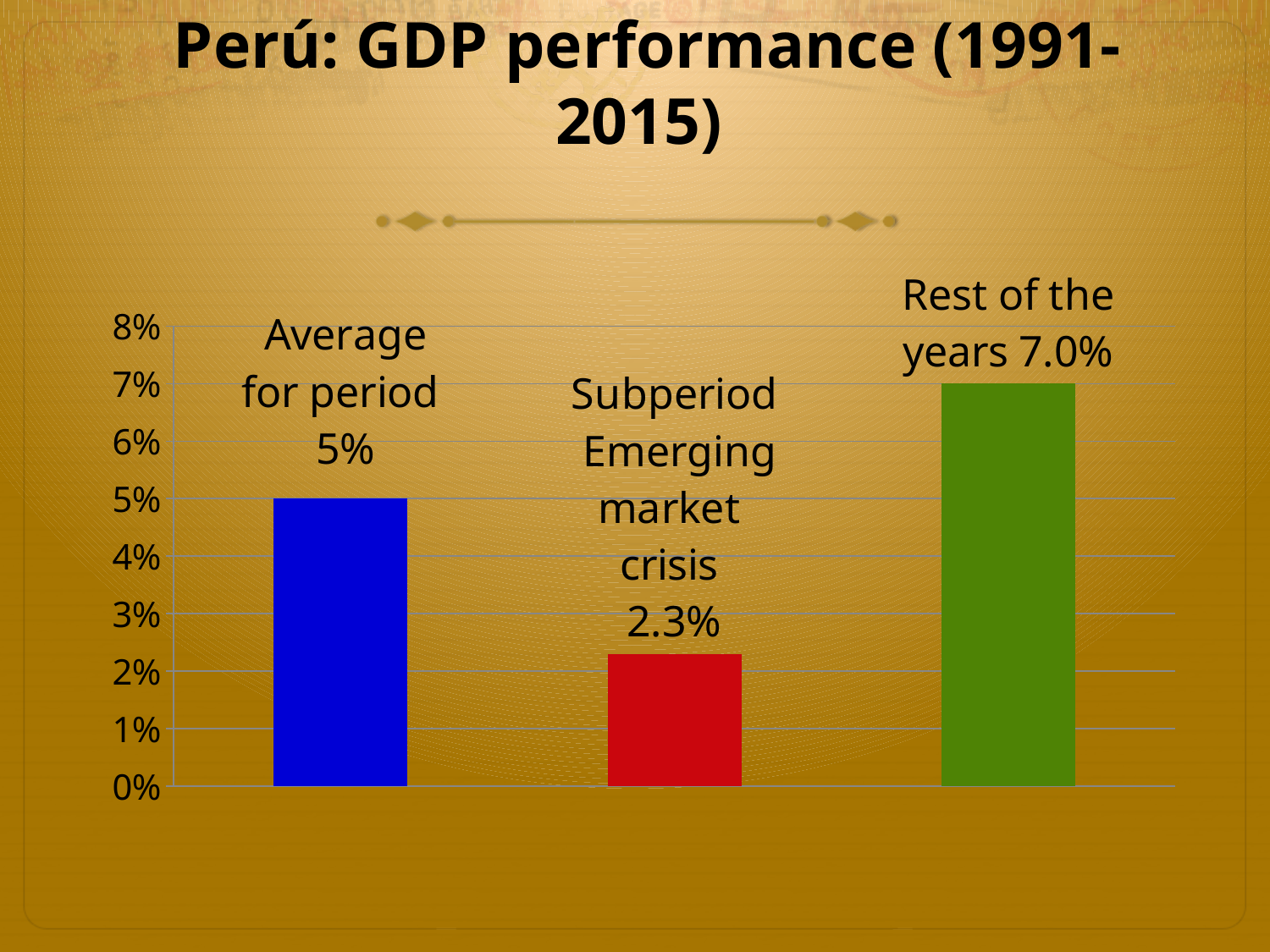
Which category has the highest value? Rest of the years Which category has the lowest value? Subperiod Emerging market crisis Is the value for 'Rest of the years' greater or less than 6%? greater Is the value for 'Subperiod Emerging market crisis' greater or less than 3%? less What is the value shown for 'Average for period'? 5% What colour is the bar for 'Rest of the years'? Green Which is larger: the value for 'Average for period' or the value for 'Subperiod Emerging market crisis'? Average for period What is the value shown for 'Rest of the years'? 7.0% How many bars are shown in the chart? 3 What is the value shown for 'Subperiod Emerging market crisis'? 2.3% What is the difference between the 'Rest of the years' value and the 'Subperiod Emerging market crisis' value? 4.7% What kind of chart is shown on the slide? Bar chart